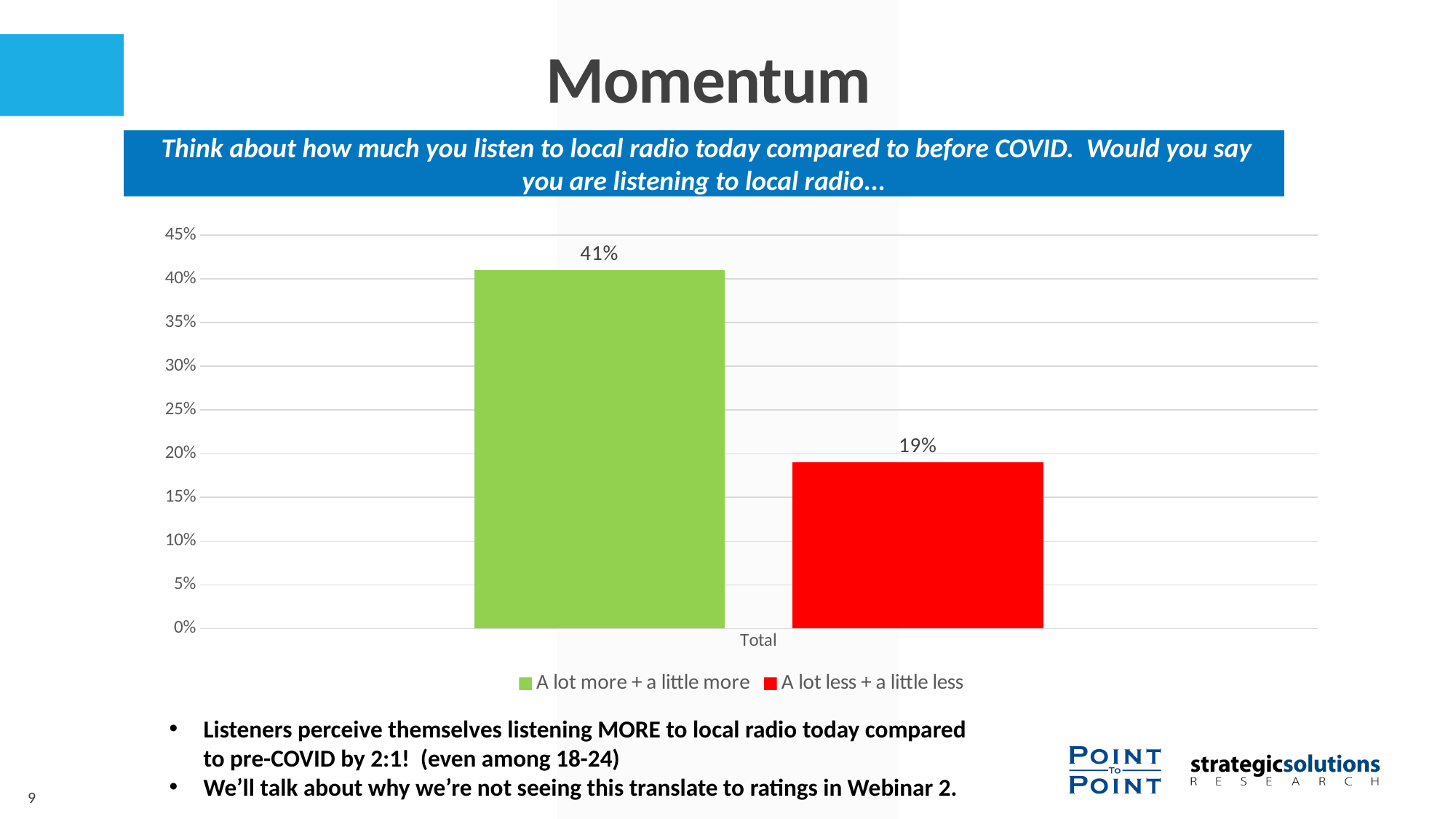
What percentage of listeners say they listen to local radio 'A lot more + a little more' compared to before COVID? 41% How many series does the legend list? 2 Is the value for 'A lot less + a little less' greater or less than 20%? less What is the difference in percentage points between 'A lot more + a little more' and 'A lot less + a little less'? 22 percentage points Which series has the higher value: 'A lot more + a little more' or 'A lot less + a little less'? A lot more + a little more What colour is the bar for 'A lot less + a little less'? Red Is the value for 'A lot more + a little more' greater or less than 40%? greater What is the highest value shown on the y axis? 45% What is the category label shown on the x axis? Total What percentage of listeners say they listen to local radio 'A lot less + a little less' compared to before COVID? 19% Which series has the lower value in the chart? A lot less + a little less What kind of chart is shown on the slide? Bar chart